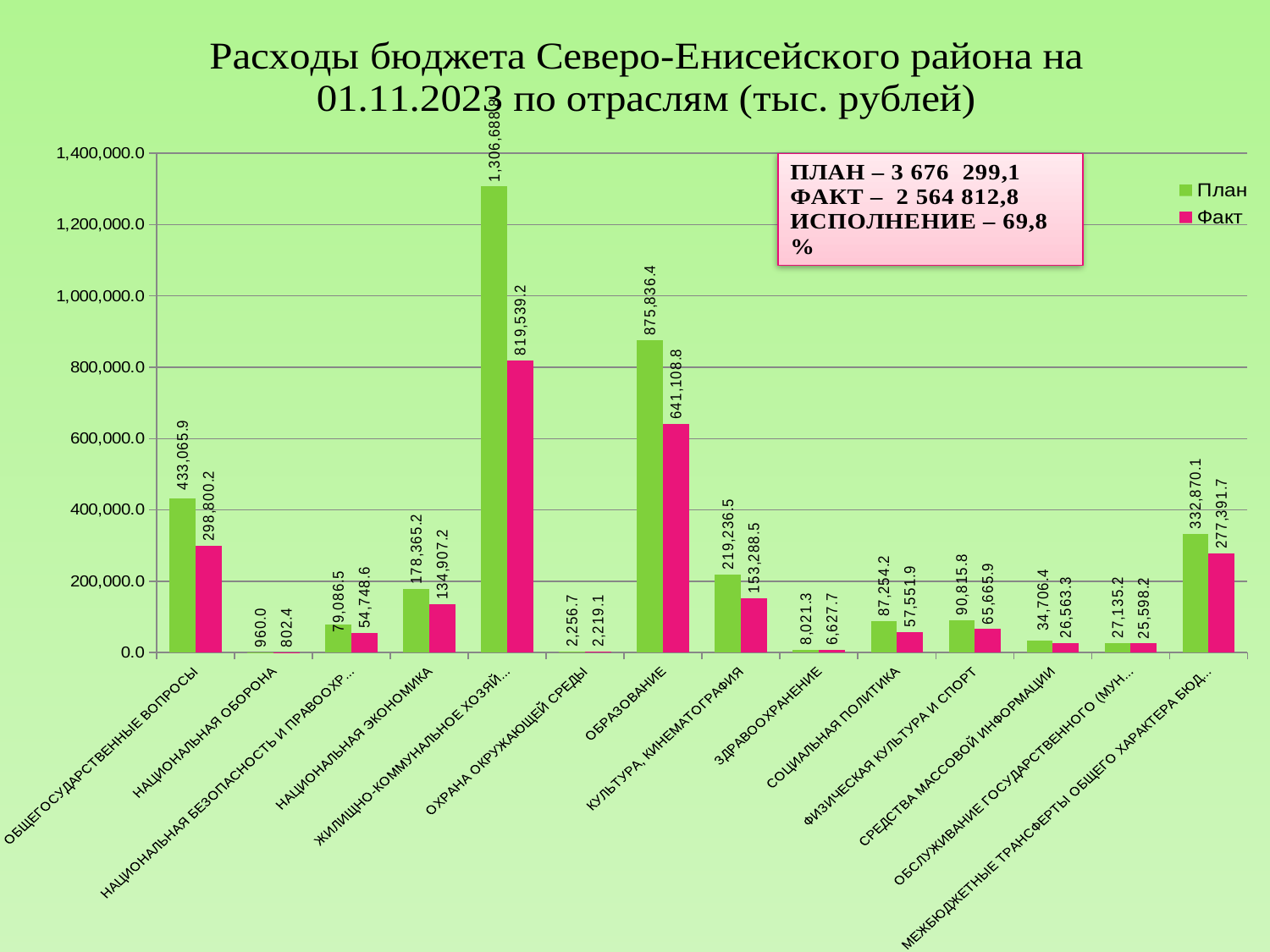
Which category has the highest План value? ЖИЛИЩНО-КОММУНАЛЬНОЕ ХОЗЯЙ... How many series does the legend list? 2 What is the План value for НАЦИОНАЛЬНАЯ ЭКОНОМИКА? 178,365.2 Which is larger: the Факт value for КУЛЬТУРА, КИНЕМАТОГРАФИЯ or the Факт value for НАЦИОНАЛЬНАЯ ЭКОНОМИКА? КУЛЬТУРА, КИНЕМАТОГРАФИЯ What type of chart is shown on the slide? Bar chart What is the difference between the План and Факт values for ОБРАЗОВАНИЕ? 234,727.6 What is the План value for ОБРАЗОВАНИЕ? 875,836.4 Which category has the lowest План value? НАЦИОНАЛЬНАЯ ОБОРОНА What is the Факт value for ОБЩЕГОСУДАРСТВЕННЫЕ ВОПРОСЫ? 298,800.2 Is the Факт value for ОБРАЗОВАНИЕ greater or less than 600,000.0? greater What is the Факт value for ЖИЛИЩНО-КОММУНАЛЬНОЕ ХОЗЯЙ...? 819,539.2 How many categories (industries) are shown on the x axis? 14